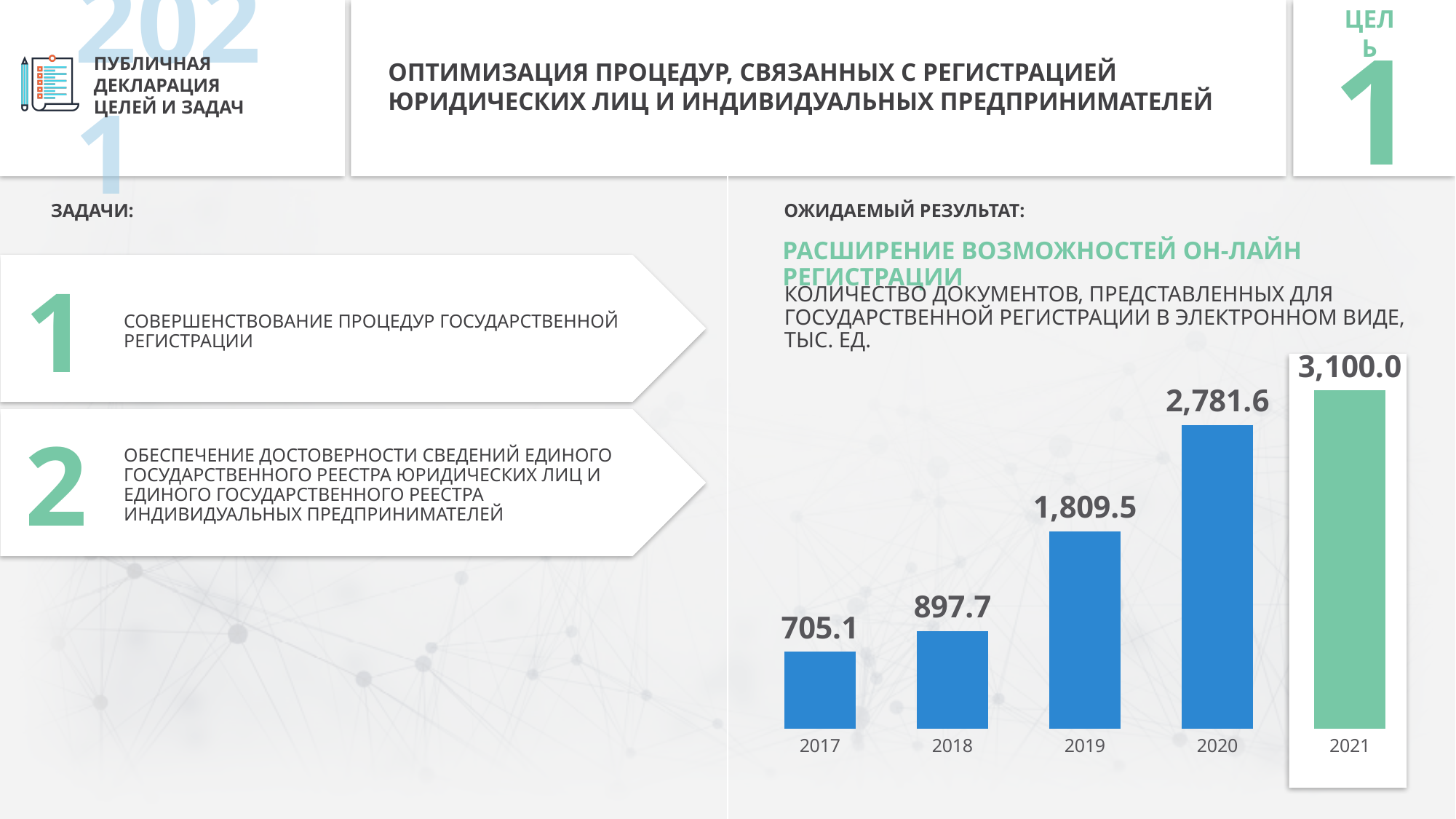
What is the value shown for 2021? 3,100.0 What is the value shown for 2019? 1,809.5 Which is larger, the value for 2019 or the value for 2018? 2019 What kind of chart is shown on the slide? bar chart Which year has the lowest value in the chart? 2017 Do the values rise or fall from 2017 to 2021? rise What is the difference between the values for 2021 and 2020? 318.4 What is the value shown for 2017? 705.1 How many years are shown on the x axis of the chart? 5 What is the value shown for 2020? 2,781.6 Which year has the highest value in the chart? 2021 What is the difference between the values for 2018 and 2017? 192.6